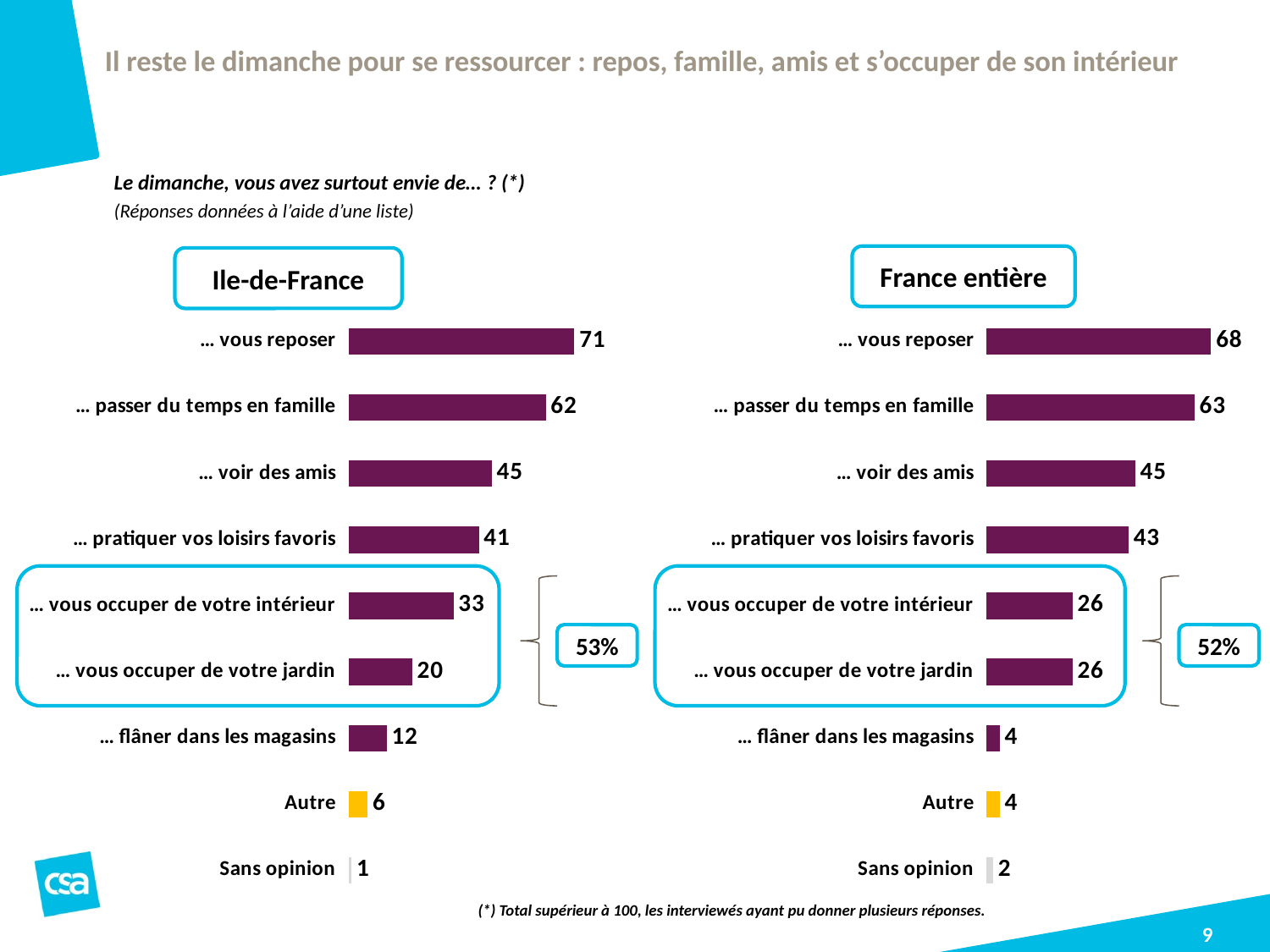
In the France entière chart, which category has the lowest value? Sans opinion What type of chart is used for the France entière data? Bar chart In the France entière chart, what is the difference between "… voir des amis" and "… flâner dans les magasins"? 41 In the Ile-de-France chart, what is the value for "… vous reposer"? 71 In the France entière chart, what is the value for "… passer du temps en famille"? 63 In the Ile-de-France chart, what is the difference between "… vous reposer" and "… passer du temps en famille"? 9 In the France entière chart, what is the value for "… vous occuper de votre jardin"? 26 In the Ile-de-France chart, how many categories are shown? 9 In the Ile-de-France chart, which category has the highest value? … vous reposer In the Ile-de-France chart, what is the value for "Autre"? 6 Which is larger: "… vous occuper de votre intérieur" in the Ile-de-France chart or in the France entière chart? Ile-de-France What percentage is shown in the callout next to the highlighted categories in the France entière chart? 52%